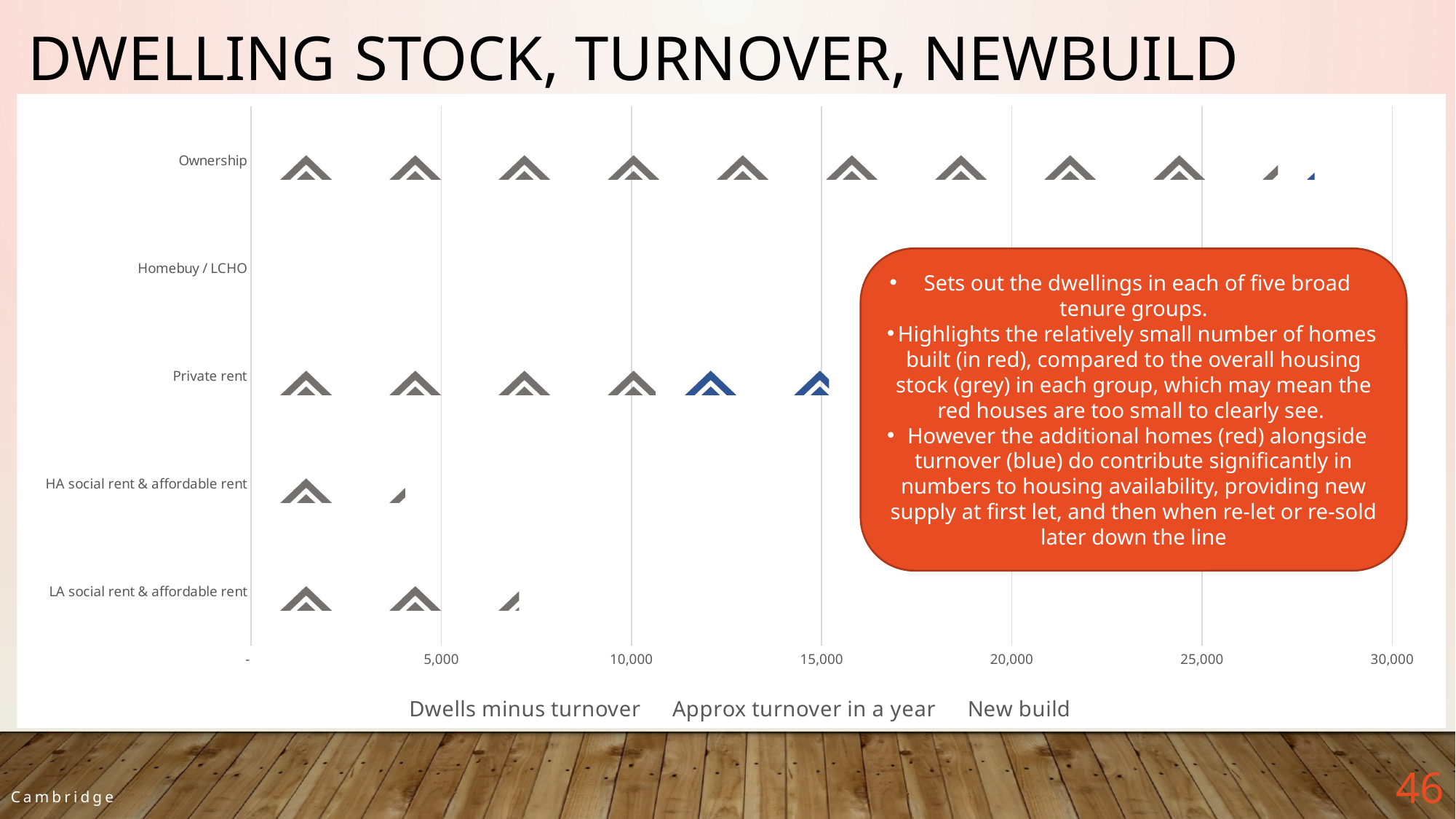
Which tenure category has the longest bar (largest total) in the chart? Ownership How many tenure categories are listed on the vertical axis of the chart? 5 Which tenure category has the smallest total in the chart? Homebuy / LCHO Is the total for LA social rent & affordable rent greater or less than 10,000? less Which has the larger total, LA social rent & affordable rent or HA social rent & affordable rent? LA social rent & affordable rent Is the total for HA social rent & affordable rent greater or less than 5,000? less What kind of chart is shown on the slide? bar chart What is the title of the slide containing the chart? DWELLING STOCK, TURNOVER, NEWBUILD How many series does the chart legend list? 3 Which has the larger total, Ownership or Private rent? Ownership Is the total for Ownership greater or less than 25,000? greater